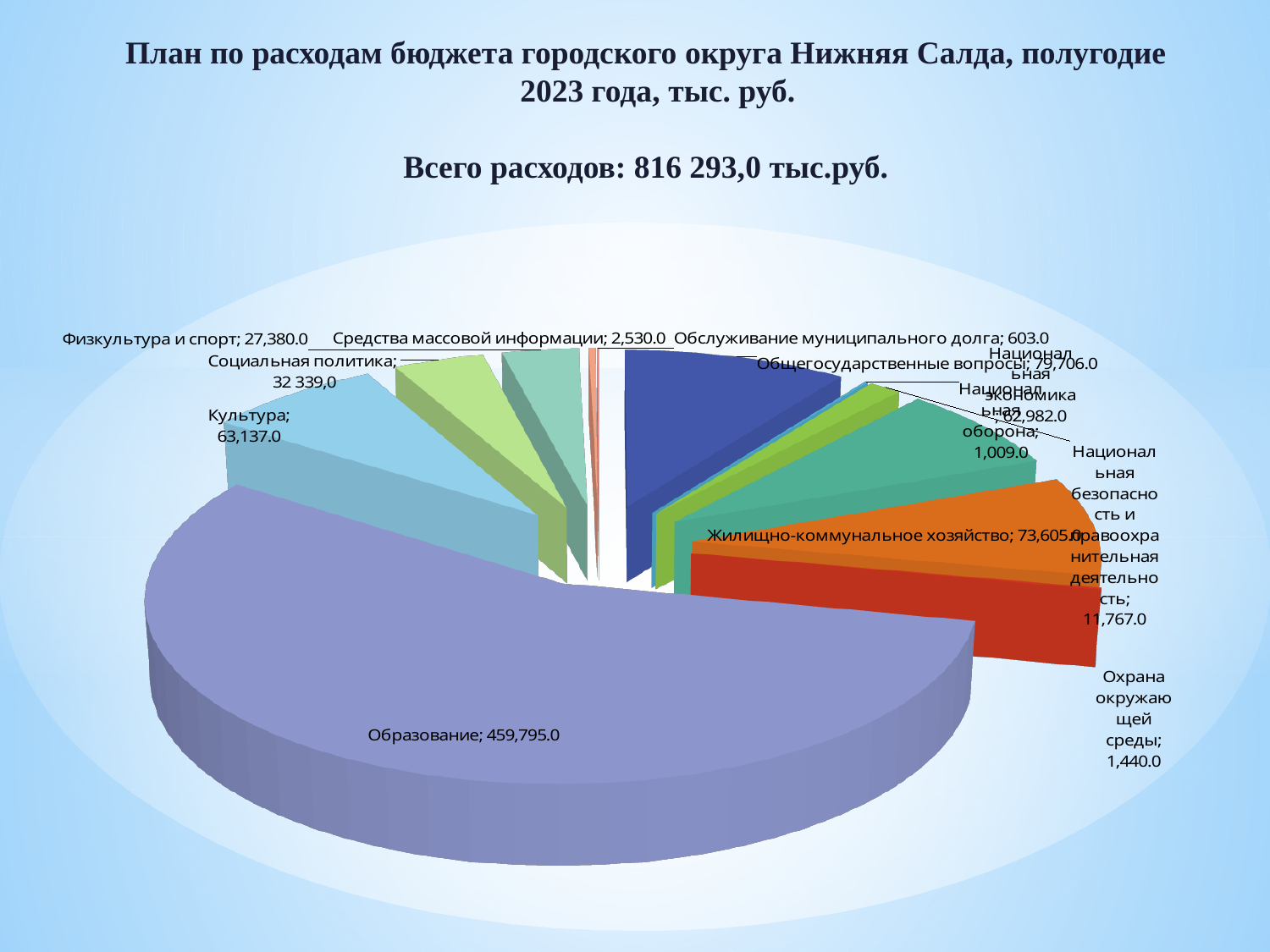
What kind of chart is shown on the slide? Pie chart Which category has the largest share of the pie? Образование What is the difference between Общегосударственные вопросы and Жилищно-коммунальное хозяйство? 6,101.0 What is the value for Образование? 459,795.0 Which category has the smallest value? Обслуживание муниципального долга What is the difference between Физкультура и спорт and Средства массовой информации? 24,850.0 How many categories are shown in the pie chart? 12 Which is larger, Культура or Национальная экономика? Культура What total expenditure is stated in the slide title? 816 293,0 тыс.руб. What is the value for Жилищно-коммунальное хозяйство? 73,605.0 What is the value for Обслуживание муниципального долга? 603.0 What is the value for Общегосударственные вопросы? 79,706.0